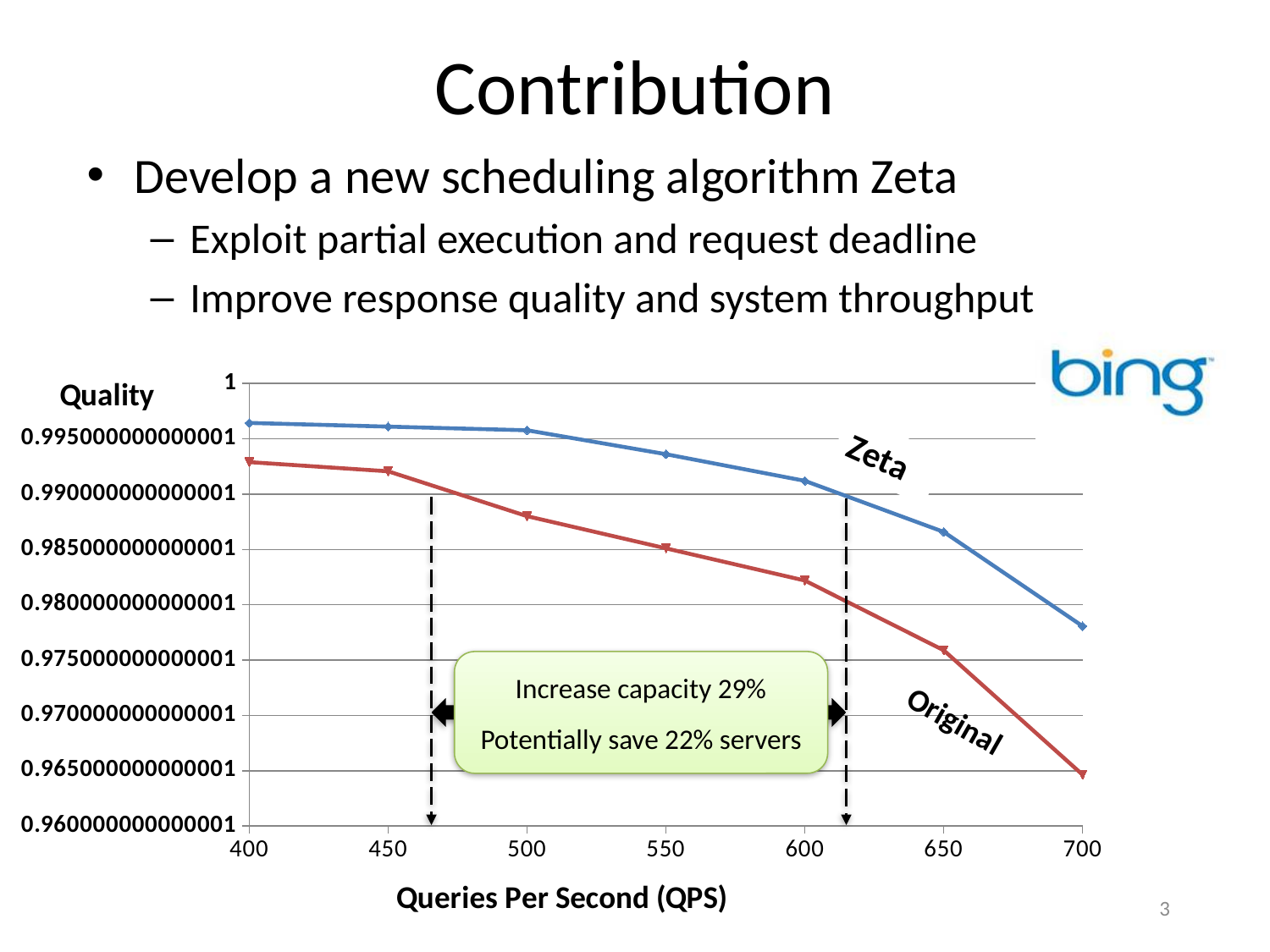
What is the title of the x axis of the chart? Queries Per Second (QPS) How many QPS values are marked along the x axis of the chart? 7 Does the Quality of the Original series rise or fall as Queries Per Second increases? fall Is the Quality of the Zeta series at 700 QPS greater or less than 0.98? less What kind of chart is shown on the slide? line chart Is the Quality of the Original series at 500 QPS greater or less than 0.99? less Which series has the higher Quality at 700 QPS, Zeta or Original? Zeta Does the Quality of the Zeta series rise or fall as Queries Per Second increases? fall How many series are plotted on the chart? 2 Which series has the higher Quality at 500 QPS, Zeta or Original? Zeta Is the Quality of the Original series at 400 QPS greater or less than 0.99? greater What label is shown on the y axis of the chart? Quality